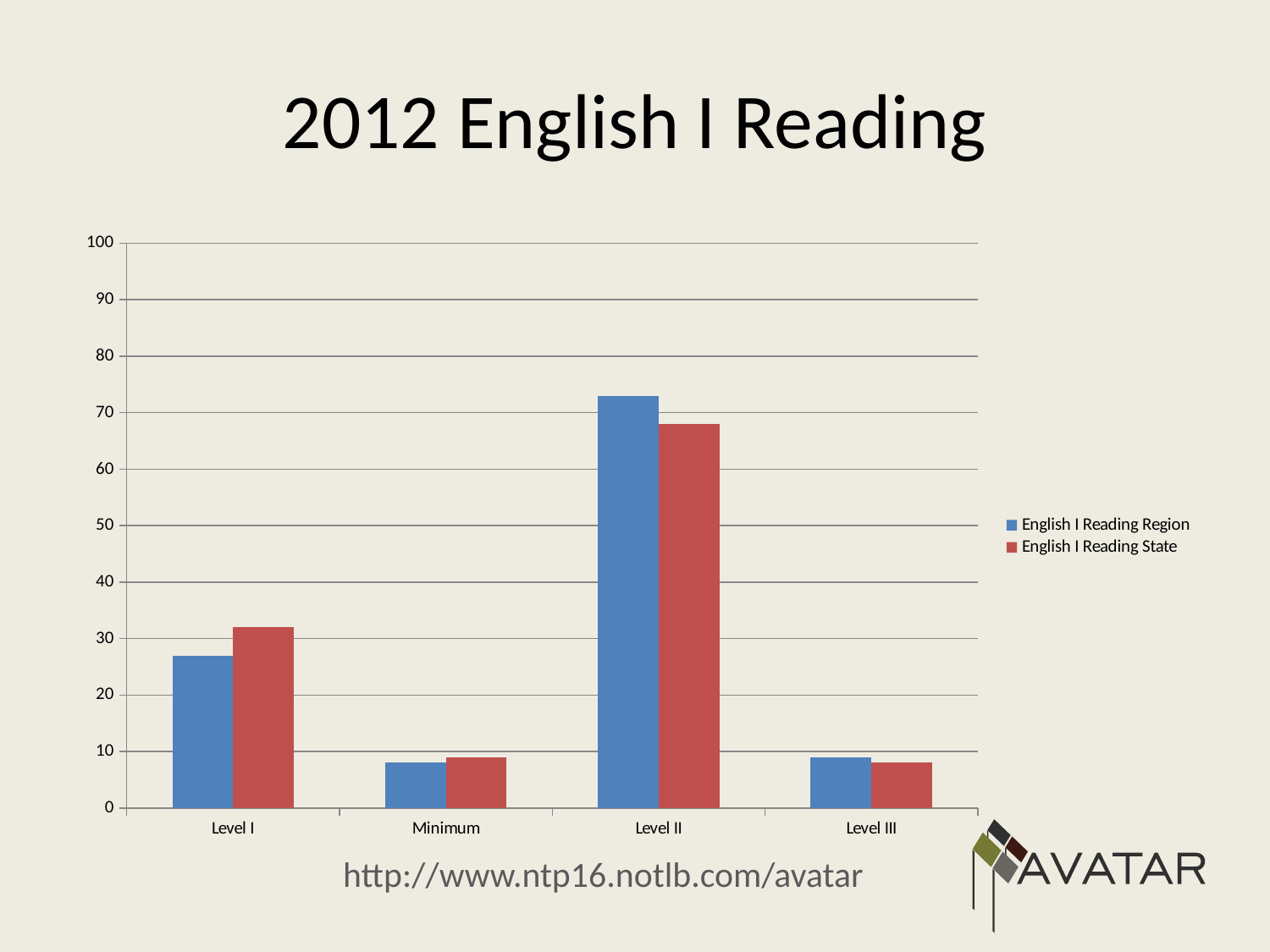
Is the value for English I Reading State at Level II greater or less than 70? less Which colour represents English I Reading State in the legend? red For Level I, which is larger: English I Reading Region or English I Reading State? English I Reading State Is the value for English I Reading State at Level I greater or less than 30? greater Which category has the highest value for English I Reading Region? Level II How many categories are shown on the x axis? 4 Which category has the highest value for English I Reading State? Level II Is the value for English I Reading Region at Level II greater or less than 70? greater What kind of chart is shown on the slide? bar chart What is the title of the slide's chart? 2012 English I Reading For Level II, which is larger: English I Reading Region or English I Reading State? English I Reading Region How many series does the legend list? 2